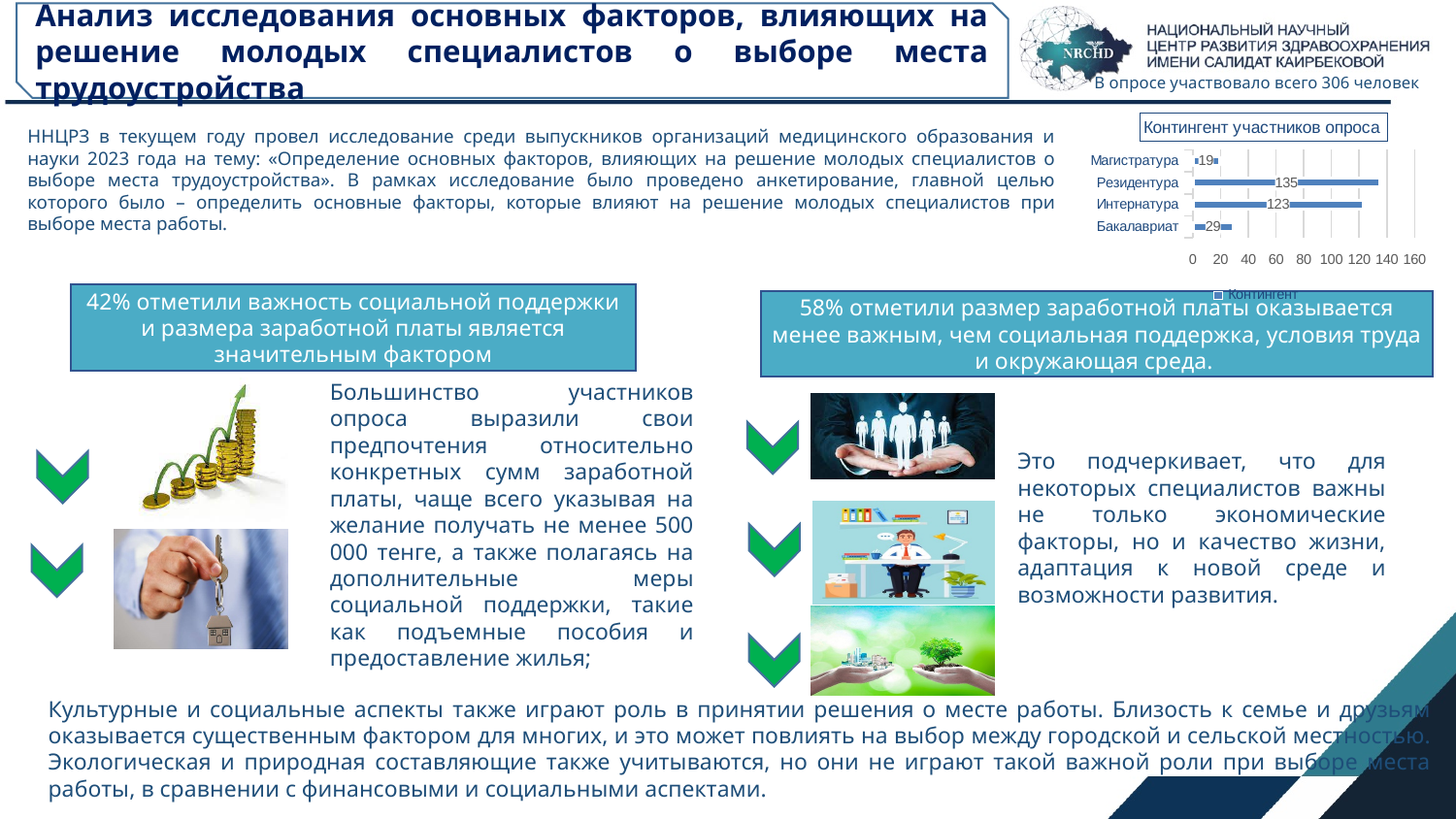
What type of chart is 'Контингент участников опроса'? Bar chart How many categories are shown in the chart 'Контингент участников опроса'? 4 What is the value for Интернатура in the chart? 123 What is the value for Бакалавриат in the chart? 29 Which is larger, the value for Бакалавриат or the value for Магистратура? Бакалавриат Which category has the lowest value in the chart? Магистратура What is the title of the chart on the slide? Контингент участников опроса What is the difference between the values for Резидентура and Интернатура? 12 What is the difference between the values for Бакалавриат and Магистратура? 10 What is the value for Резидентура in the chart 'Контингент участников опроса'? 135 What is the value for Магистратура in the chart? 19 Which category has the highest value in the chart 'Контингент участников опроса'? Резидентура